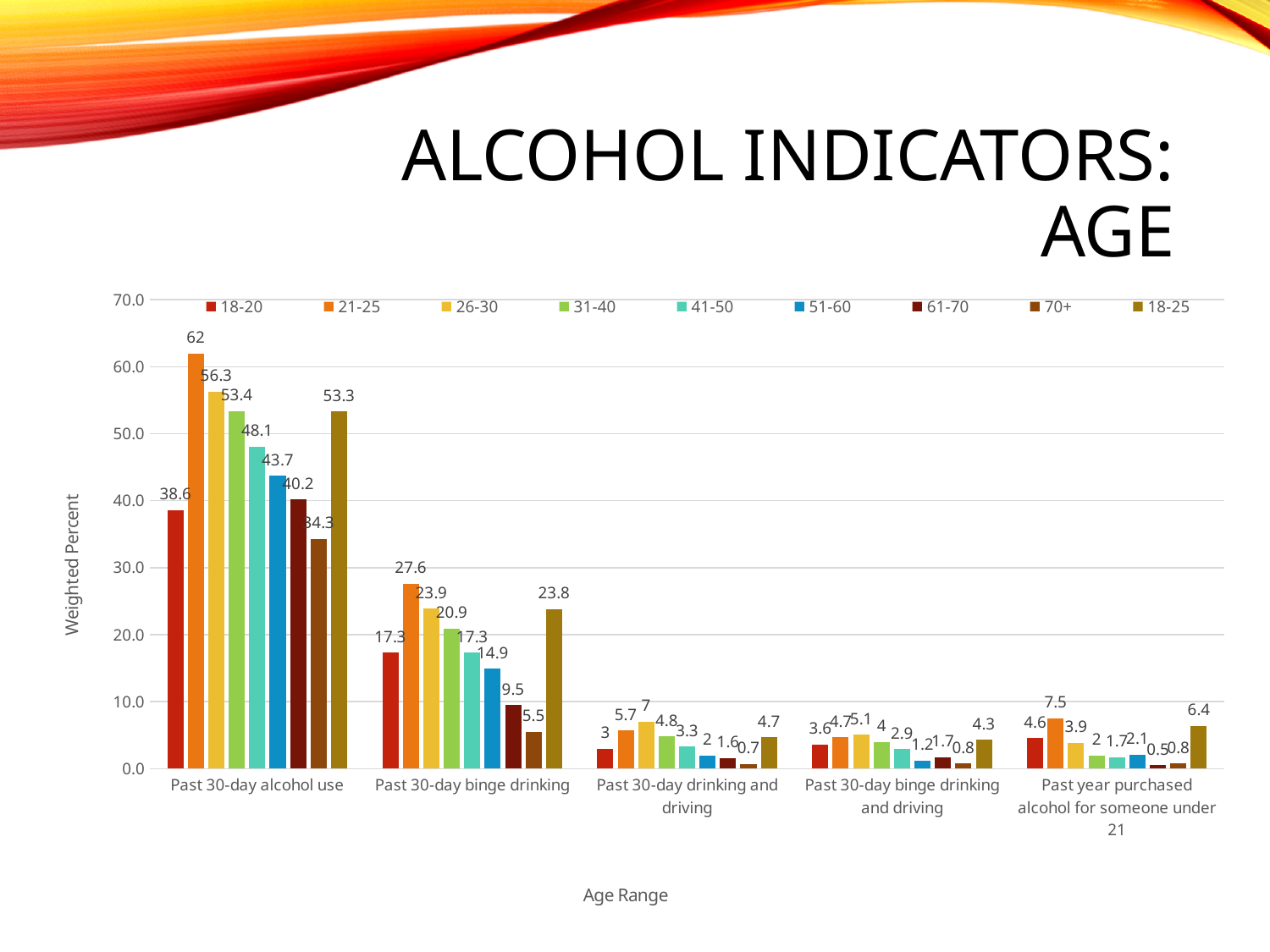
Which age group has the highest value for Past 30-day drinking and driving? 26-30 What kind of chart is shown on the slide? Bar chart How many age-group series does the legend list? 9 What is the value for the 70+ age group for Past 30-day binge drinking? 5.5 What is the value for the 21-25 age group for Past 30-day alcohol use? 62 What is the label of the vertical axis? Weighted Percent What is the difference between the 21-25 and 18-20 values for Past 30-day alcohol use? 23.4 Which age group has the lowest value for Past 30-day alcohol use? 70+ What is the difference between the 21-25 and 26-30 values for Past 30-day binge drinking? 3.7 What is the value for the 18-25 age group for Past year purchased alcohol for someone under 21? 6.4 How many indicator categories are shown on the x axis? 5 Which is larger for Past 30-day binge drinking: the 31-40 value or the 18-25 value? 18-25